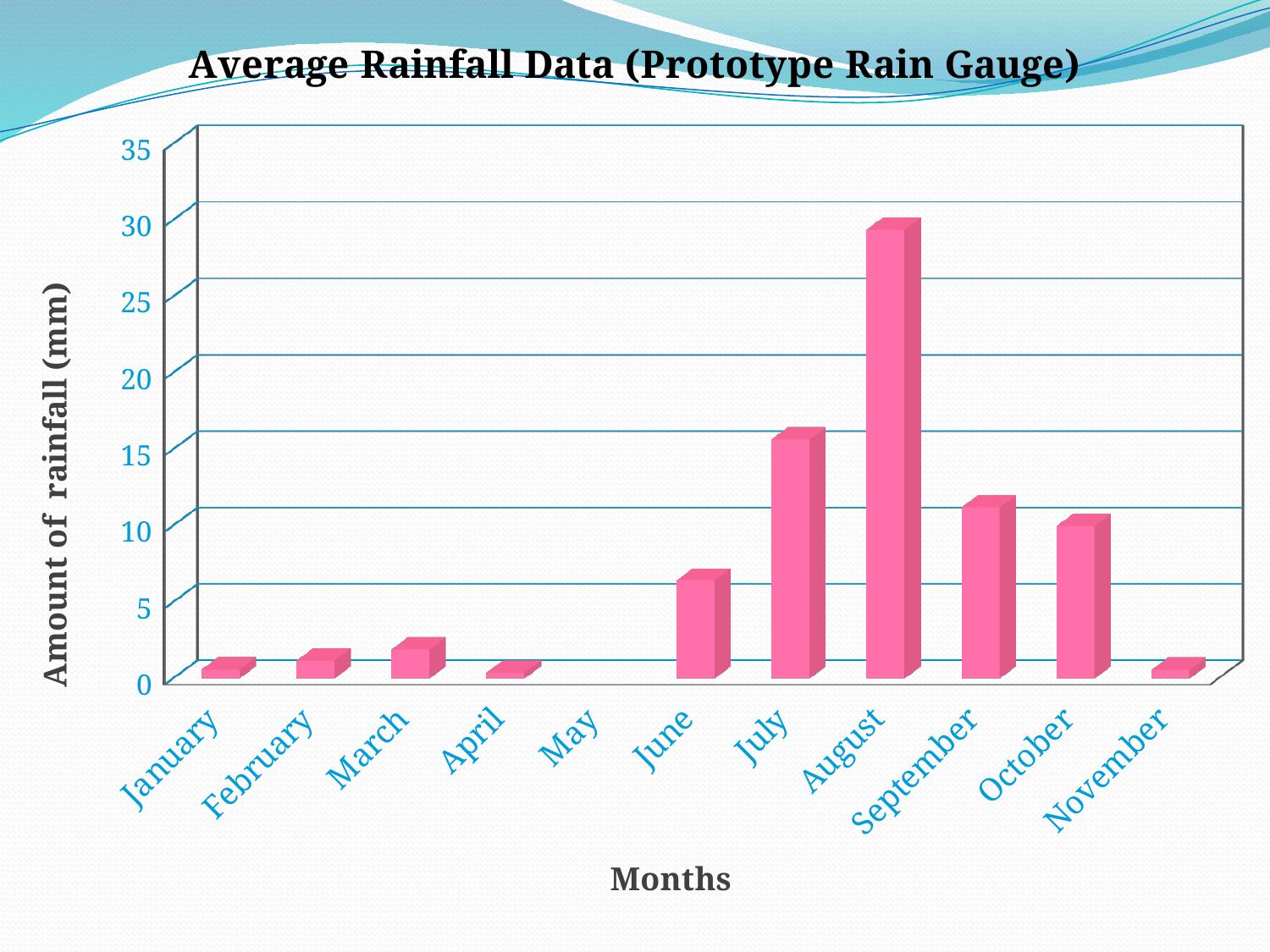
What kind of chart is shown on the slide? Bar chart Which month has more rainfall, June or October? October Is the value for July greater or less than 10? greater Is the value for March greater or less than 5? less Is the value for October greater or less than 15? less What is the label on the vertical axis? Amount of rainfall (mm) Which month has the highest amount of rainfall? August Which month shows no rainfall bar at all? May Do the values rise or fall from August to November? fall How many months are shown on the x axis? 11